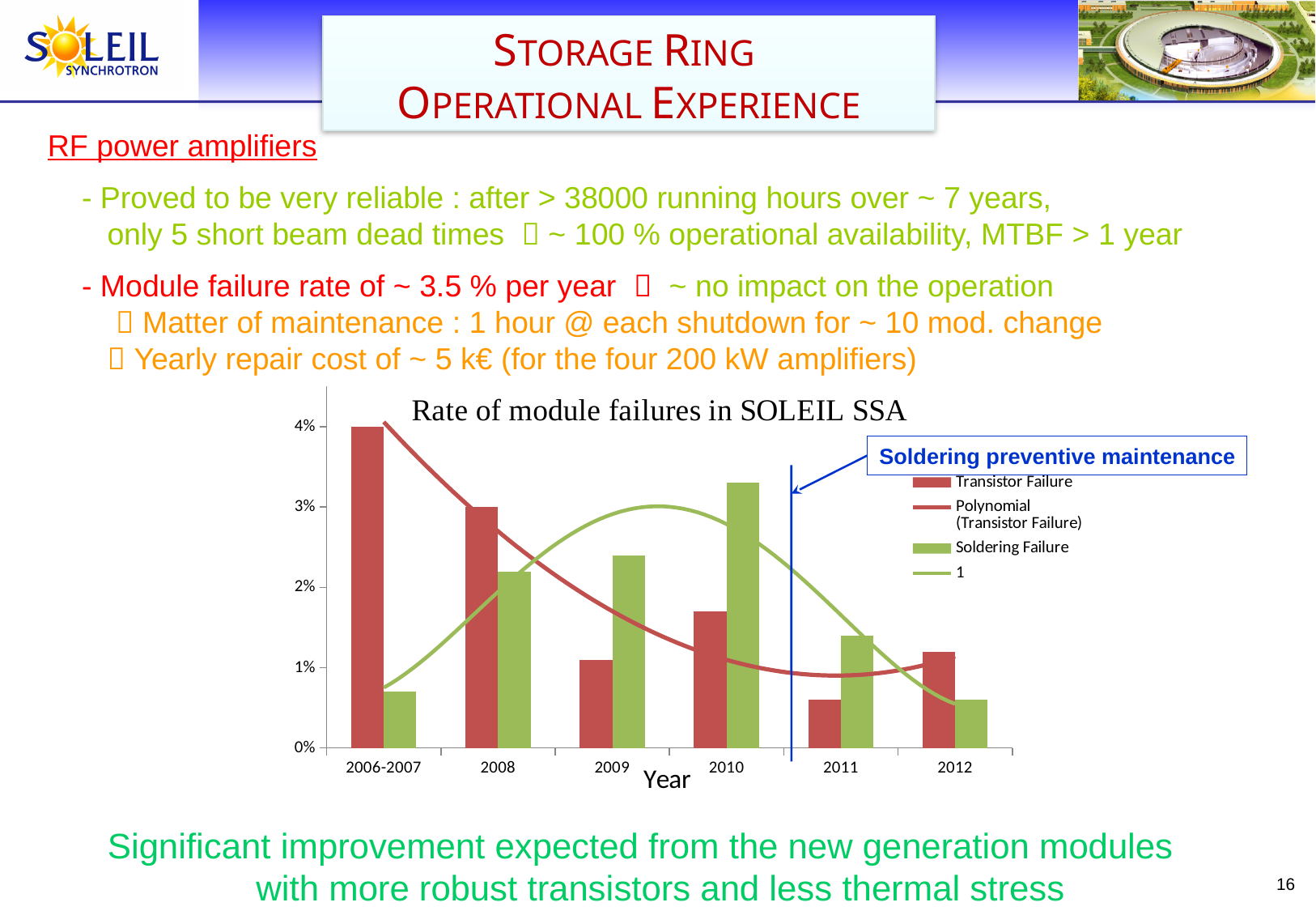
In 2008, which is larger: the Transistor Failure rate or the Soldering Failure rate? Transistor Failure How many entries does the chart legend list? 4 Is the Soldering Failure rate for 2010 greater or less than 3%? greater Is the Soldering Failure rate for 2006-2007 greater or less than 1%? less How many year categories are shown on the x axis of the chart? 6 In which year is the Soldering Failure rate highest? 2010 What does the annotation box with the blue vertical line on the chart say? Soldering preventive maintenance Is the Transistor Failure rate for 2011 greater or less than 1%? less In which year is the Transistor Failure rate lowest? 2011 What is the title of the chart? Rate of module failures in SOLEIL SSA In which year category is the Transistor Failure rate highest? 2006-2007 What kind of chart is used to show the Transistor Failure and Soldering Failure data? Bar chart